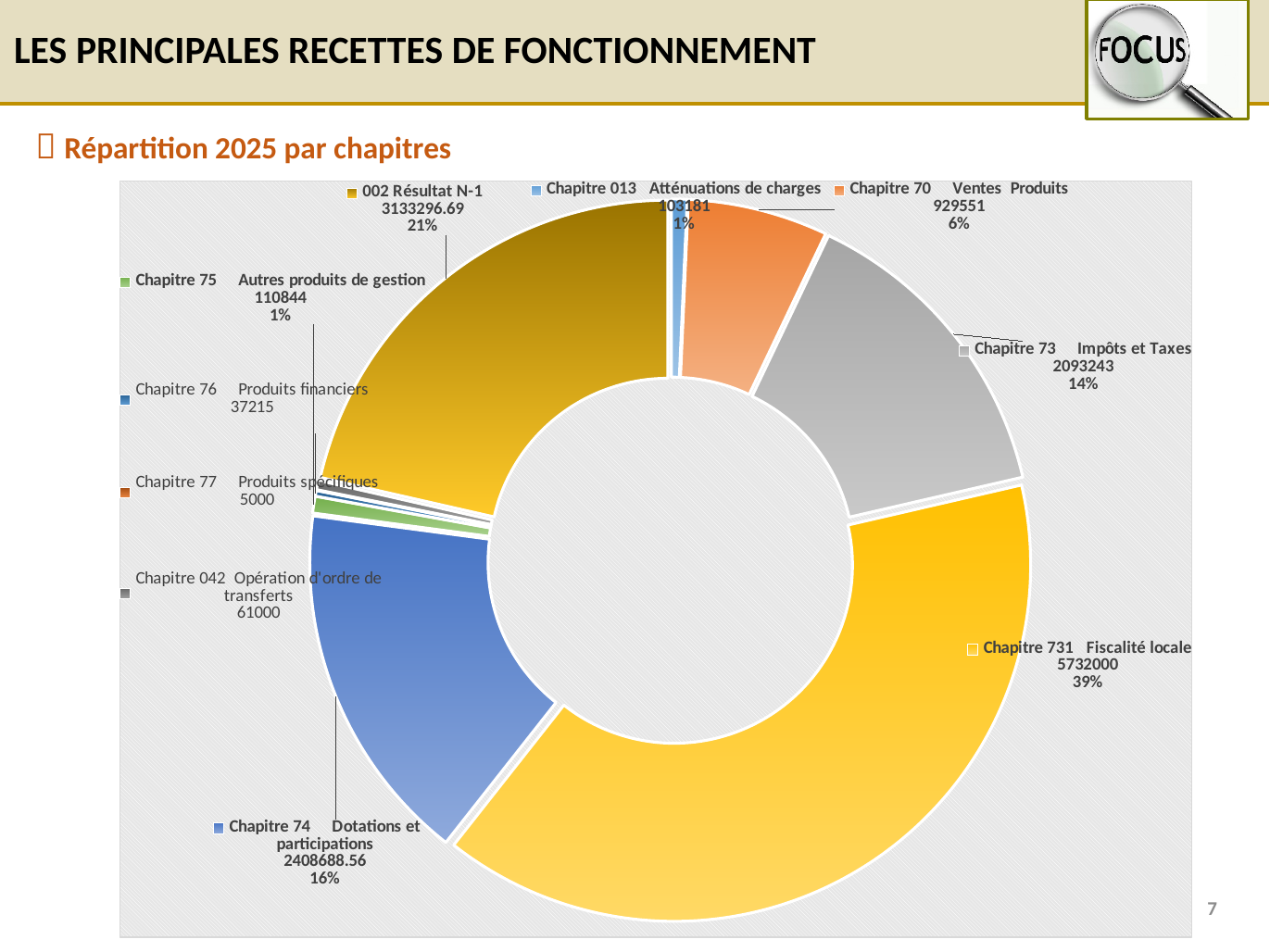
What kind of chart is shown on the slide? Pie chart (doughnut) What share of the chart does 002 Résultat N-1 represent? 21% What is the value for Chapitre 731 Fiscalité locale? 5732000 How many categories are shown in the chart? 10 What is the difference between the values for Chapitre 731 Fiscalité locale and Chapitre 74 Dotations et participations? 3323311.44 Which is larger, the value for Chapitre 73 Impôts et Taxes or the value for Chapitre 70 Ventes Produits? Chapitre 73 Impôts et Taxes What is the value for Chapitre 76 Produits financiers? 37215 What is the value for Chapitre 74 Dotations et participations? 2408688.56 What share of the chart does Chapitre 70 Ventes Produits represent? 6% Which category has the largest share of the chart? Chapitre 731 Fiscalité locale What is the value for Chapitre 73 Impôts et Taxes? 2093243 Which category has the smallest value in the chart? Chapitre 77 Produits spécifiques